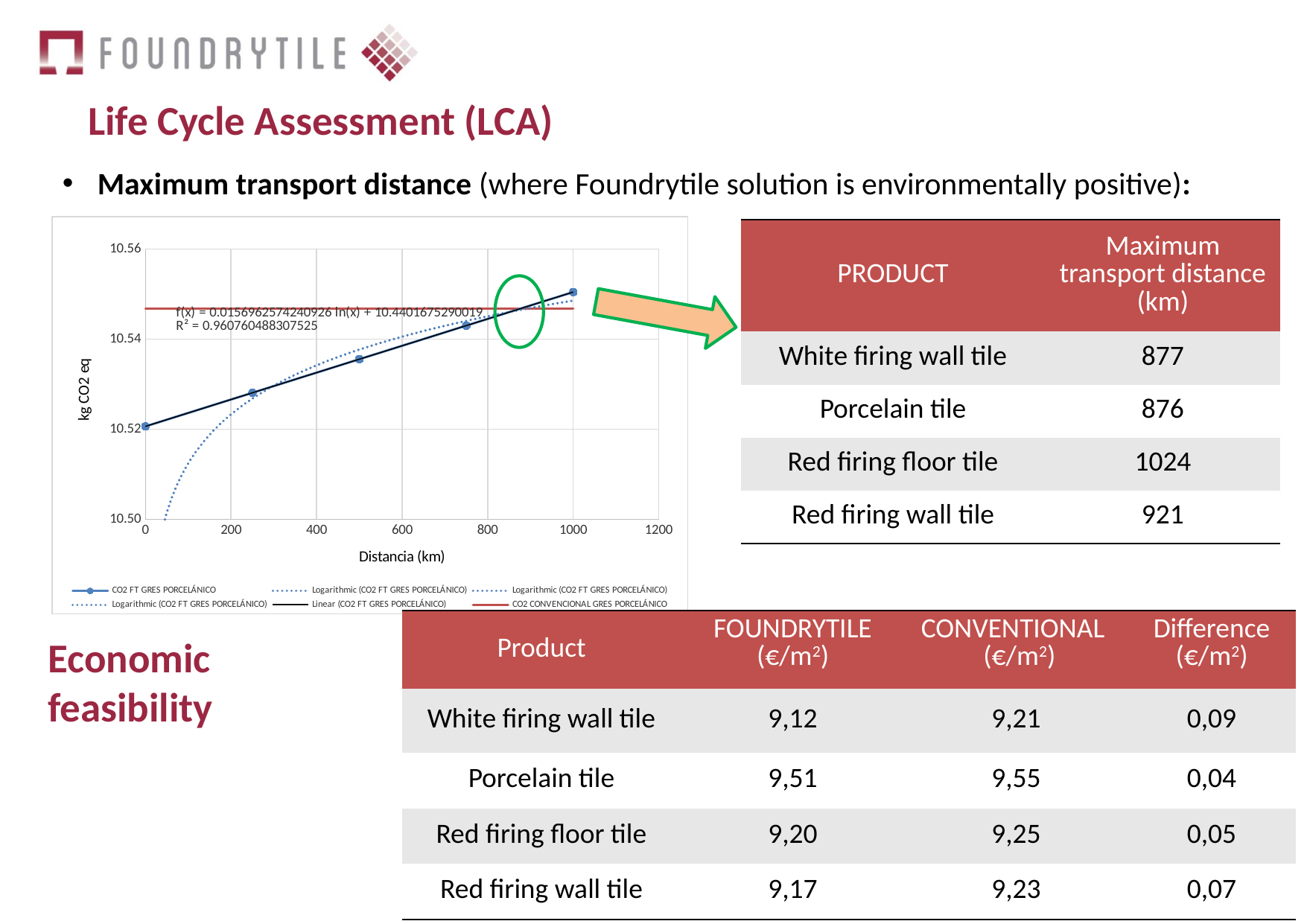
At which distance is the CO2 FT GRES PORCELÁNICO value lowest? 0 km Is the CO2 FT GRES PORCELÁNICO value at 500 km greater or less than 10.52? greater How many data points are plotted for the CO2 FT GRES PORCELÁNICO series? 5 What is the title of the chart's x axis? Distancia (km) At 1000 km, is the CO2 FT GRES PORCELÁNICO point above or below the CO2 CONVENCIONAL GRES PORCELÁNICO line? above Is the CO2 FT GRES PORCELÁNICO value at 0 km greater or less than 10.54? less At which distance is the CO2 FT GRES PORCELÁNICO value highest? 1000 km Does the CO2 FT GRES PORCELÁNICO value rise or fall as the distance increases? rise What kind of chart is shown on the slide? line chart What R² value is printed on the chart? 0.960760488307525 Is the CO2 FT GRES PORCELÁNICO value at 1000 km greater or less than 10.54? greater How many entries does the chart legend list? 6